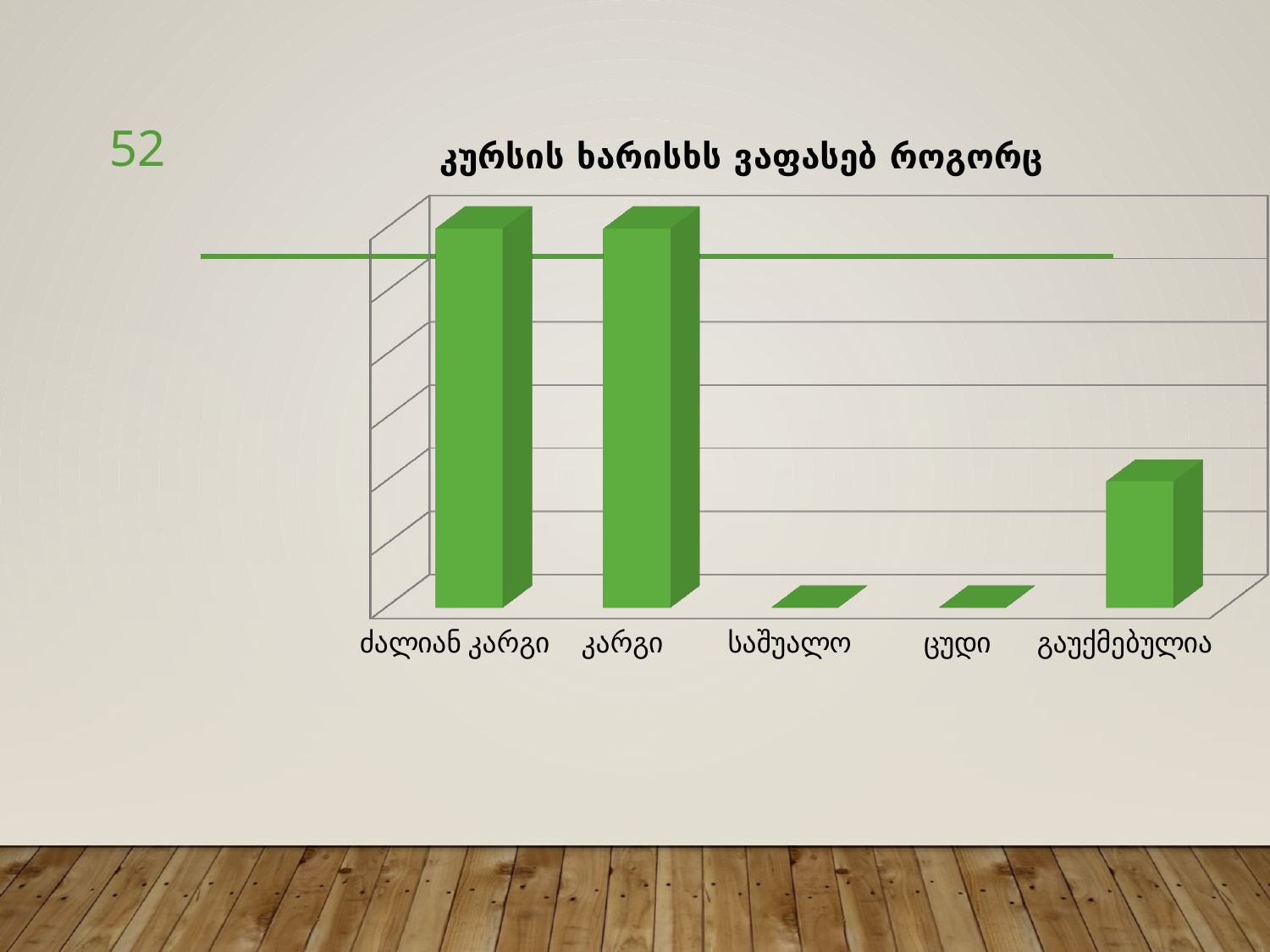
Which is larger, the value for გაუქმებულია or the value for ცუდი? გაუქმებულია What is the title of the chart? კურსის ხარისხს ვაფასებ როგორც Which is larger, the value for კარგი or the value for გაუქმებულია? კარგი Which is larger, the value for ძალიან კარგი or the value for გაუქმებულია? ძალიან კარგი What is the label of the first category on the x axis? ძალიან კარგი What colour are the bars in the chart? green How many categories are shown on the x axis of the chart? 5 What kind of chart is shown on the slide? bar chart